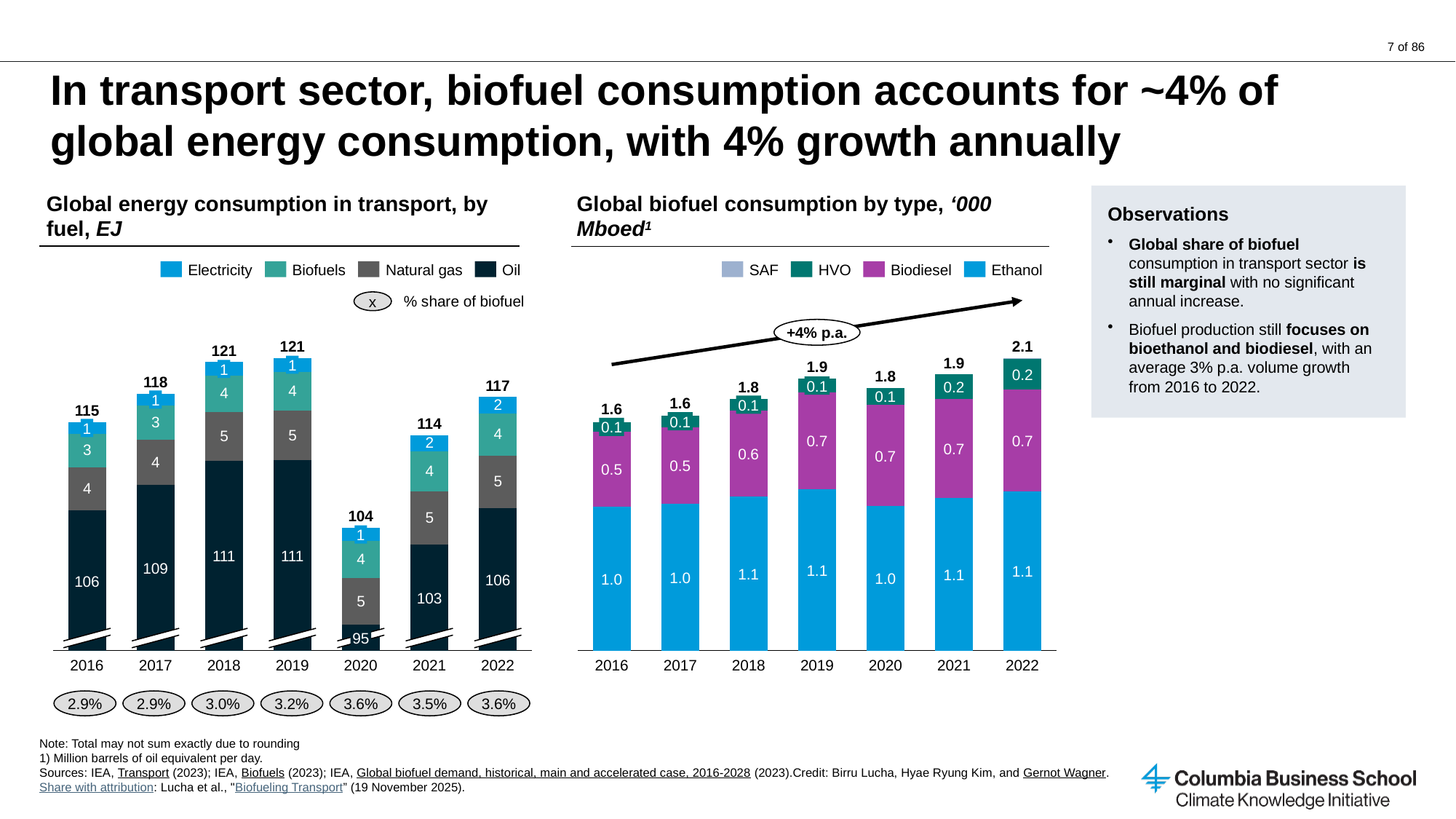
In the 'Global energy consumption in transport, by fuel' chart, what is the difference between the total for 2018 and the total for 2016? 6 What type of chart is the 'Global biofuel consumption by type' chart? Stacked bar chart In the 'Global energy consumption in transport, by fuel' chart, how many series does the legend list? 4 In the 'Global energy consumption in transport, by fuel' chart, what is the total value for 2020? 104 In the 'Global energy consumption in transport, by fuel' chart, which year has the lowest total? 2020 In the 'Global energy consumption in transport, by fuel' chart, what is the % share of biofuel shown for 2019? 3.2% In the 'Global biofuel consumption by type' chart, what is the Biodiesel value for 2018? 0.6 In the 'Global biofuel consumption by type' chart, how many years are shown on the x axis? 7 In the 'Global biofuel consumption by type' chart, what is the total value for 2022? 2.1 In the 'Global biofuel consumption by type' chart, which year has the highest total? 2022 In the 'Global energy consumption in transport, by fuel' chart, what is the Oil value for 2019? 111 In the 'Global biofuel consumption by type' chart, is the Ethanol value for 2019 larger or smaller than the Biodiesel value for 2019? larger